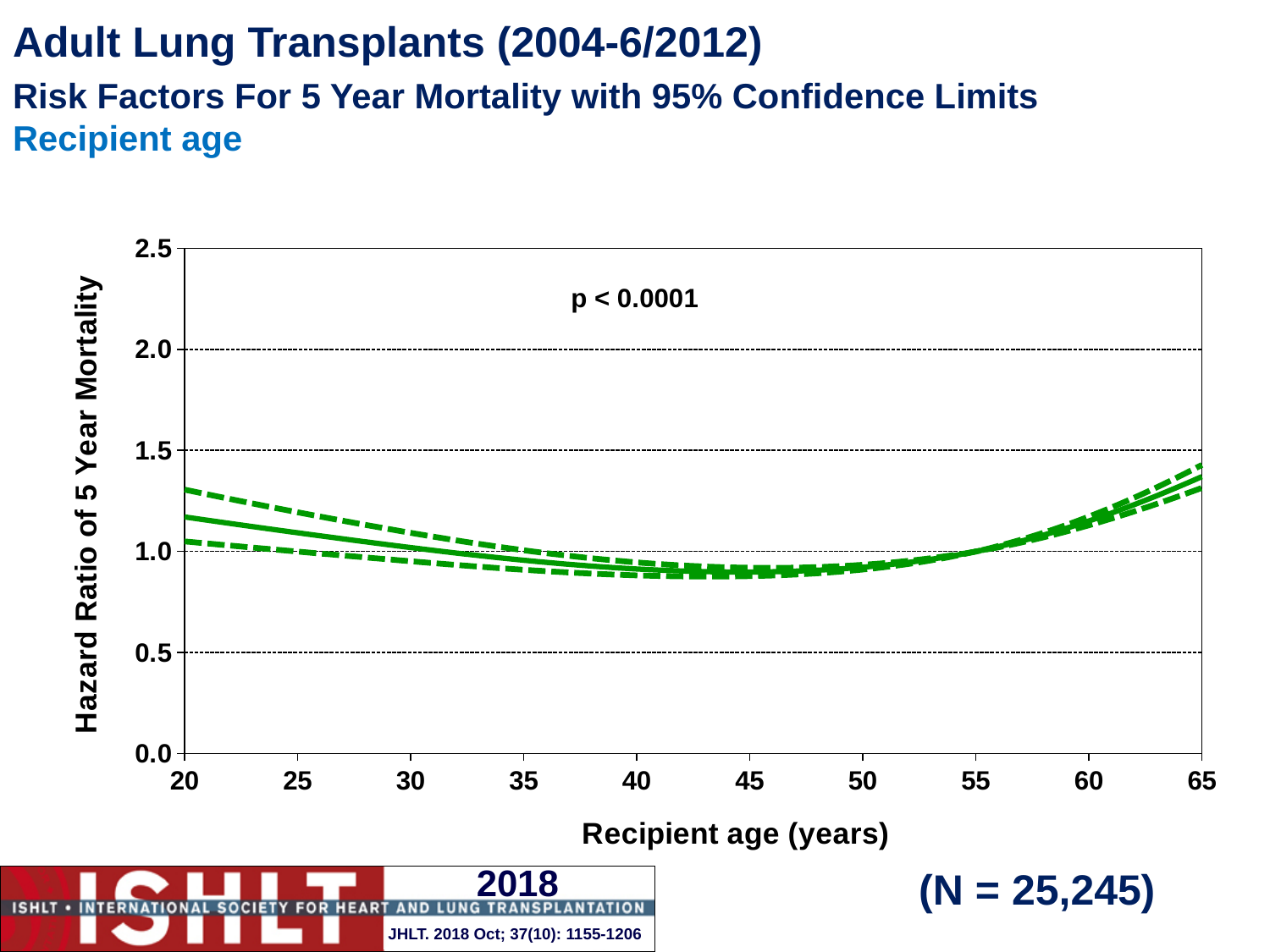
What is the sample size N shown on the slide? N = 25,245 Is the hazard ratio of 5 year mortality at recipient age 45 greater or less than 0.5? greater Is the hazard ratio of 5 year mortality at recipient age 65 greater or less than 1.5? less Is the hazard ratio of 5 year mortality at recipient age 20 greater or less than 1.0? greater Does the hazard ratio of 5 year mortality rise or fall as recipient age increases from 20 to 45 years? fall Is the hazard ratio of 5 year mortality higher at recipient age 65 or at recipient age 45? age 65 What kind of chart is shown on the slide? line chart Does the hazard ratio of 5 year mortality rise or fall as recipient age increases from 55 to 65 years? rise Is the hazard ratio of 5 year mortality higher at recipient age 20 or at recipient age 45? age 20 What p-value is printed on the chart? p < 0.0001